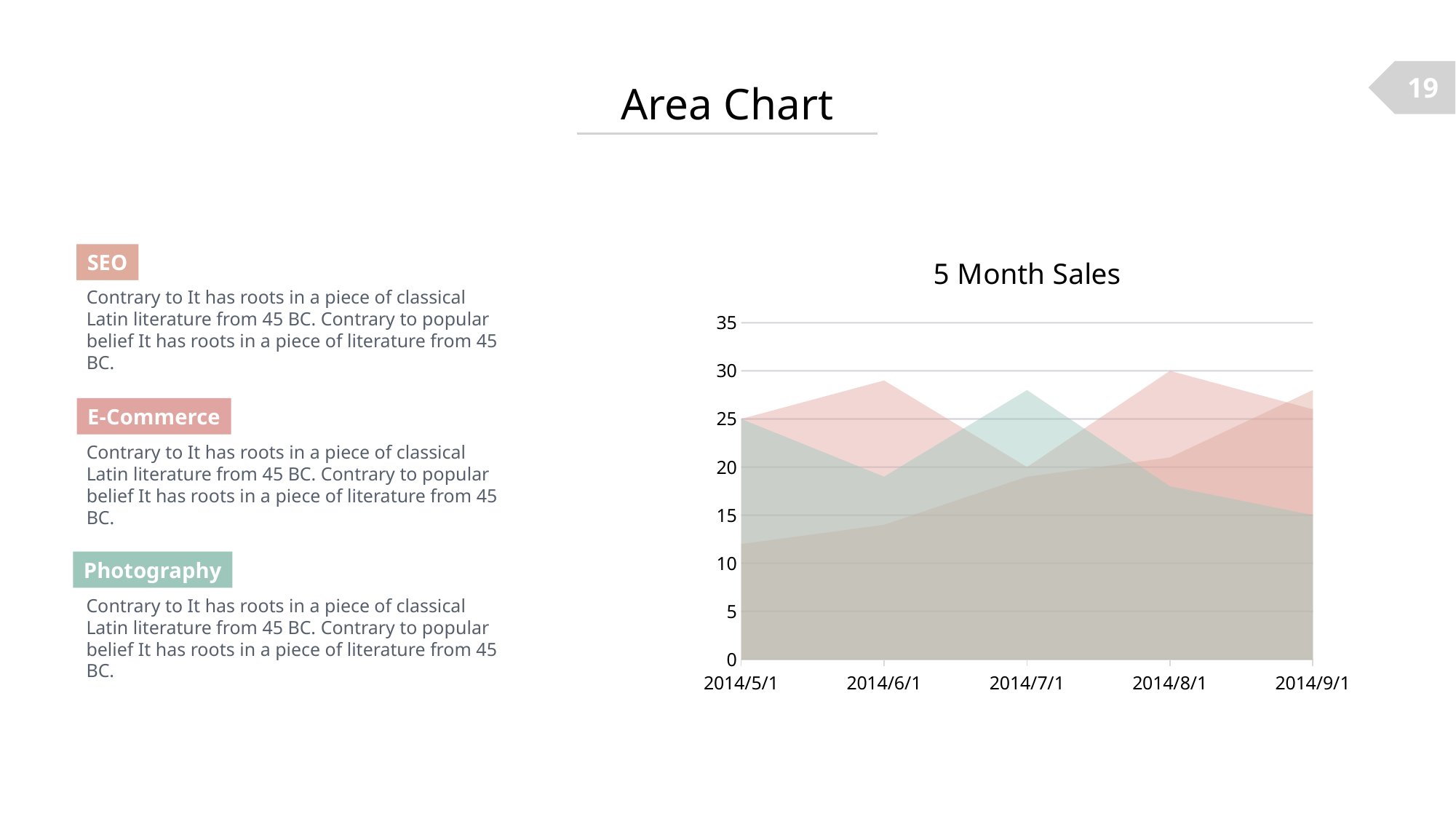
Does the grey series rise or fall from 2014/5/1 to 2014/8/1? rise Is the value of the pink series at 2014/9/1 greater or less than 20? greater Is the value of the pink series at 2014/6/1 greater or less than 25? greater What is the first date shown on the x axis of the chart? 2014/5/1 Is the value of the grey series at 2014/5/1 greater or less than 15? less What is the title of the chart? 5 Month Sales How many dates are shown on the x axis of the chart? 5 At 2014/6/1, which is larger: the pink series or the green series? pink series What kind of chart is shown on the slide? area chart At which date is the grey series at its lowest? 2014/5/1